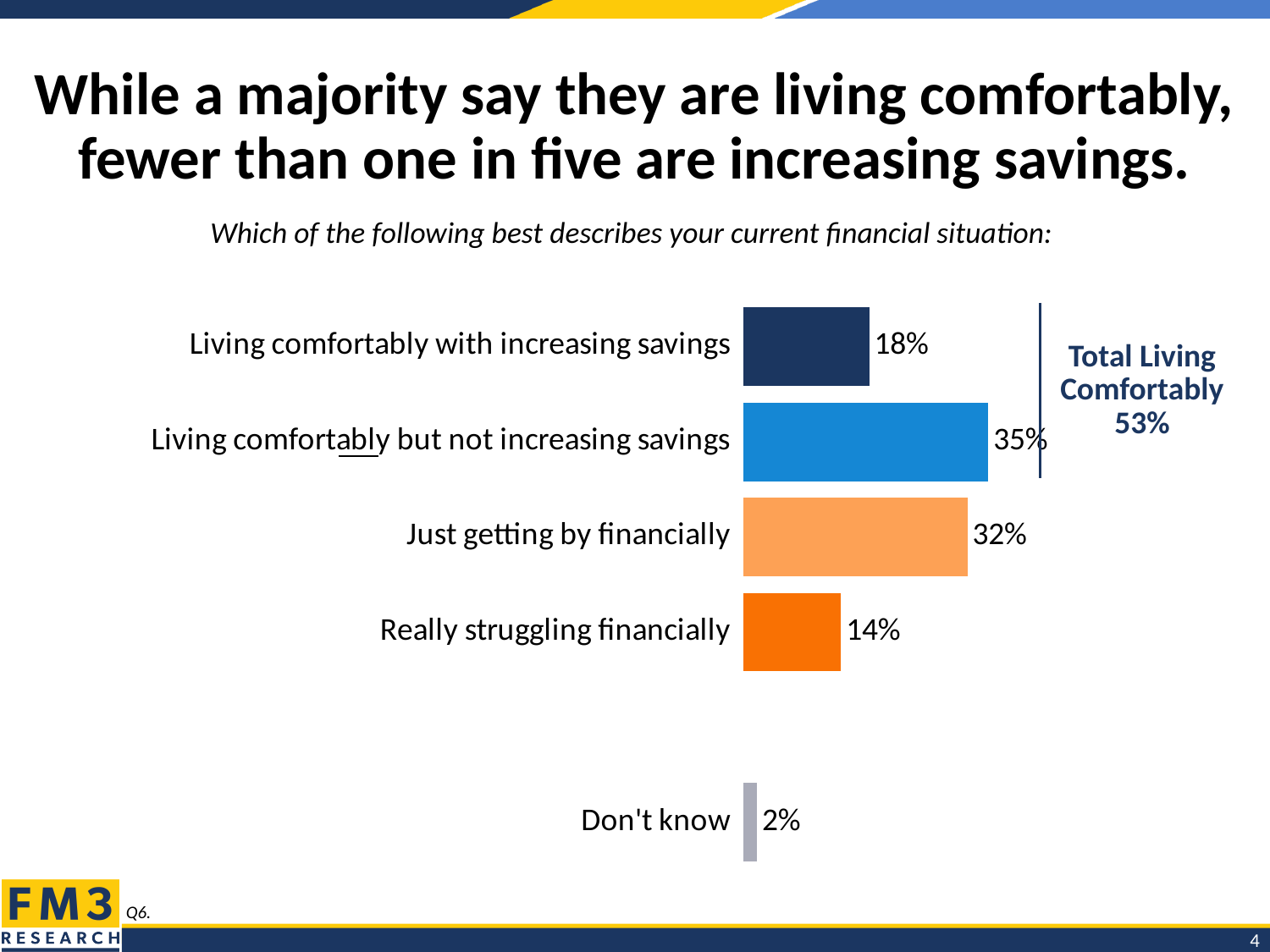
What percentage of respondents say they are living comfortably with increasing savings? 18% How many response categories are shown in the chart? 5 What percentage of respondents say they are really struggling financially? 14% What percentage of respondents say they are just getting by financially? 32% Which response category has the highest percentage? Living comfortably but not increasing savings What percentage of respondents answered "Don't know"? 2% Which response category has the lowest percentage? Don't know What is the difference in percentage points between "Living comfortably but not increasing savings" and "Living comfortably with increasing savings"? 17 Which is larger: the percentage for "Just getting by financially" or for "Really struggling financially"? Just getting by financially What kind of chart is shown on the slide? Bar chart What is the Total Living Comfortably percentage shown on the slide? 53% What percentage of respondents say they are living comfortably but not increasing savings? 35%